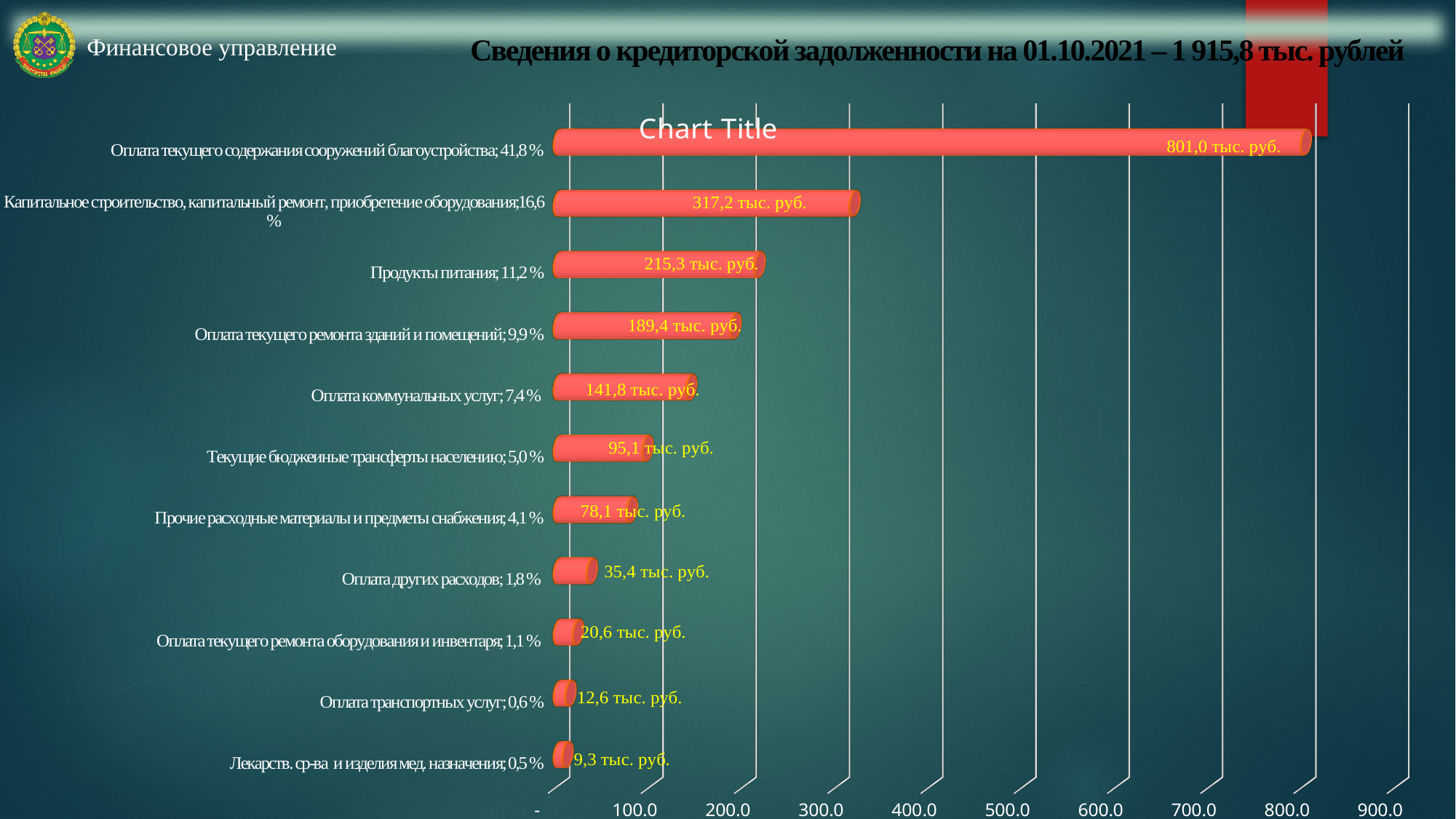
What is the value shown for Оплата транспортных услуг? 12,6 тыс. руб. Is the value for Капитальное строительство, капитальный ремонт, приобретение оборудования greater or less than 300.0? greater Which category has the highest value? Оплата текущего содержания сооружений благоустройства What is the difference between the values for Продукты питания and Оплата текущего ремонта зданий и помещений? 25,9 тыс. руб. How many categories are shown in the chart? 11 What is the value shown for Продукты питания? 215,3 тыс. руб. Which category has the lowest value? Лекарств. ср-ва и изделия мед. назначения What kind of chart is shown on the slide? bar chart What is the difference between the values for Оплата текущего содержания сооружений благоустройства and Капитальное строительство, капитальный ремонт, приобретение оборудования? 483,8 тыс. руб. What is the value shown for Оплата коммунальных услуг? 141,8 тыс. руб. What percentage share is shown next to the label Оплата других расходов? 1,8 % Which is larger: the value for Текущие бюджетные трансферты населению or the value for Прочие расходные материалы и предметы снабжения? Текущие бюджетные трансферты населению